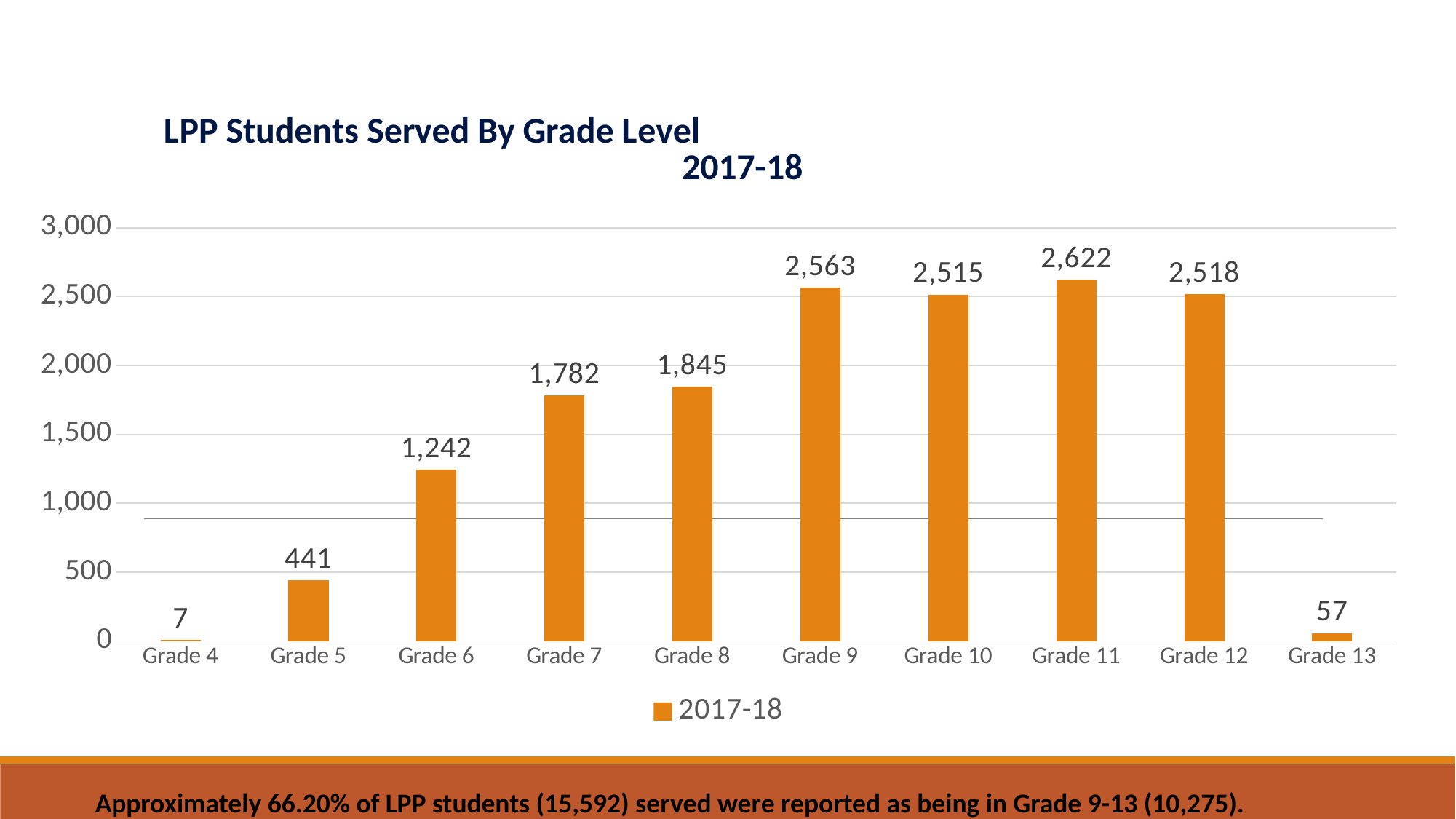
Which grade level has the highest number of LPP students served? Grade 11 How many series does the legend list? 1 Which grade level has the lowest number of LPP students served? Grade 4 What kind of chart is shown on the slide? bar chart How many grade levels are shown on the x axis? 10 What is the value for Grade 5? 441 What is the difference between the values for Grade 11 and Grade 9? 59 Is the value for Grade 10 greater or less than 2,000? greater What is the difference between the values for Grade 8 and Grade 7? 63 Which is larger, the value for Grade 6 or the value for Grade 7? Grade 7 What is the value for Grade 13? 57 What is the value for Grade 9? 2,563